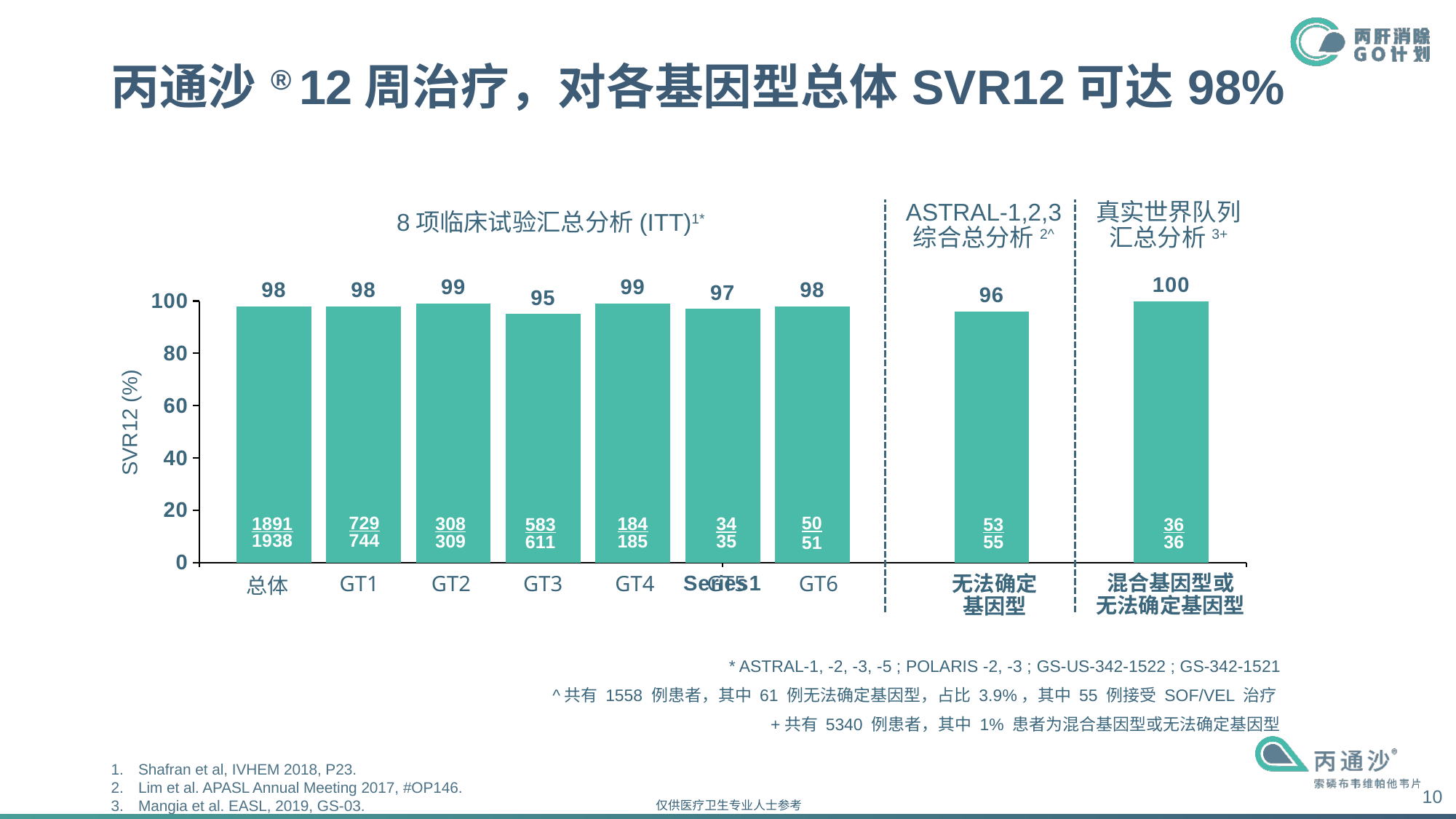
What is the difference between the SVR12 values for 混合基因型或无法确定基因型 and 无法确定基因型? 4 What is the label of the y axis? SVR12 (%) Which category has the lowest SVR12 (%) value? GT3 What is the SVR12 (%) value for 总体? 98 What kind of chart is shown on the slide? bar chart What is the SVR12 (%) value for GT3? 95 What is the SVR12 (%) value for 无法确定基因型? 96 Is the SVR12 value for GT1 greater or less than 80? greater How many bars are plotted in the chart? 9 Which category has the highest SVR12 (%) value? 混合基因型或无法确定基因型 Which has a higher SVR12 value, GT4 or 无法确定基因型? GT4 What is the difference between the SVR12 values for GT2 and GT3? 4